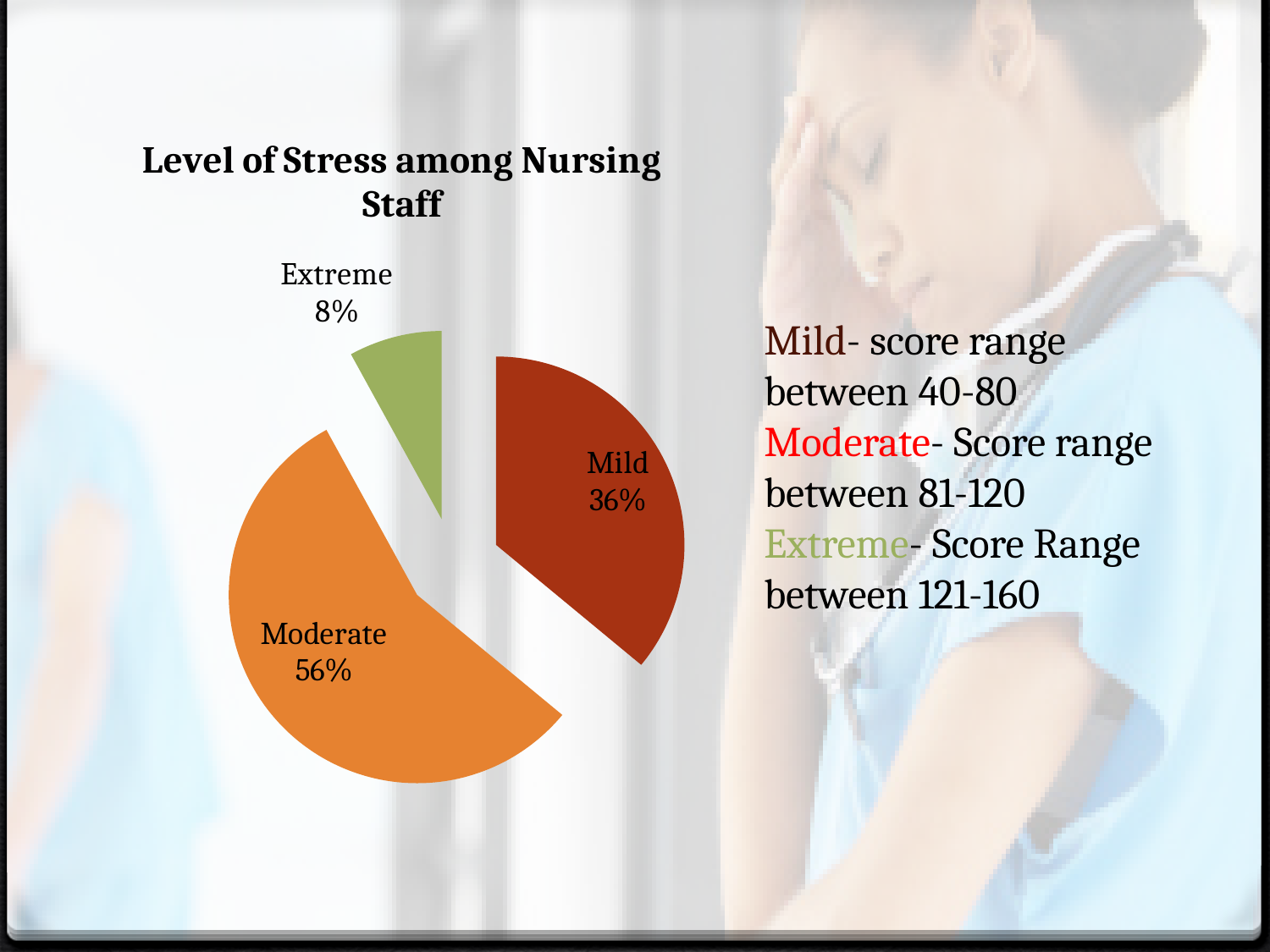
Which stress level has the smallest share of the pie? Extreme What is the difference in percentage points between the Moderate and Mild slices? 20 What is the difference in percentage points between the Mild and Extreme slices? 28 What share of nursing staff has a Moderate level of stress? 56% How many slices does the pie chart have? 3 What colour is the Extreme slice of the pie chart? Green What share of nursing staff has an Extreme level of stress? 8% Which stress level has the largest share of the pie? Moderate What share of nursing staff has a Mild level of stress? 36% Which is larger, the Mild slice or the Extreme slice? Mild What kind of chart is shown on the slide? Pie chart What is the title of the pie chart? Level of Stress among Nursing Staff